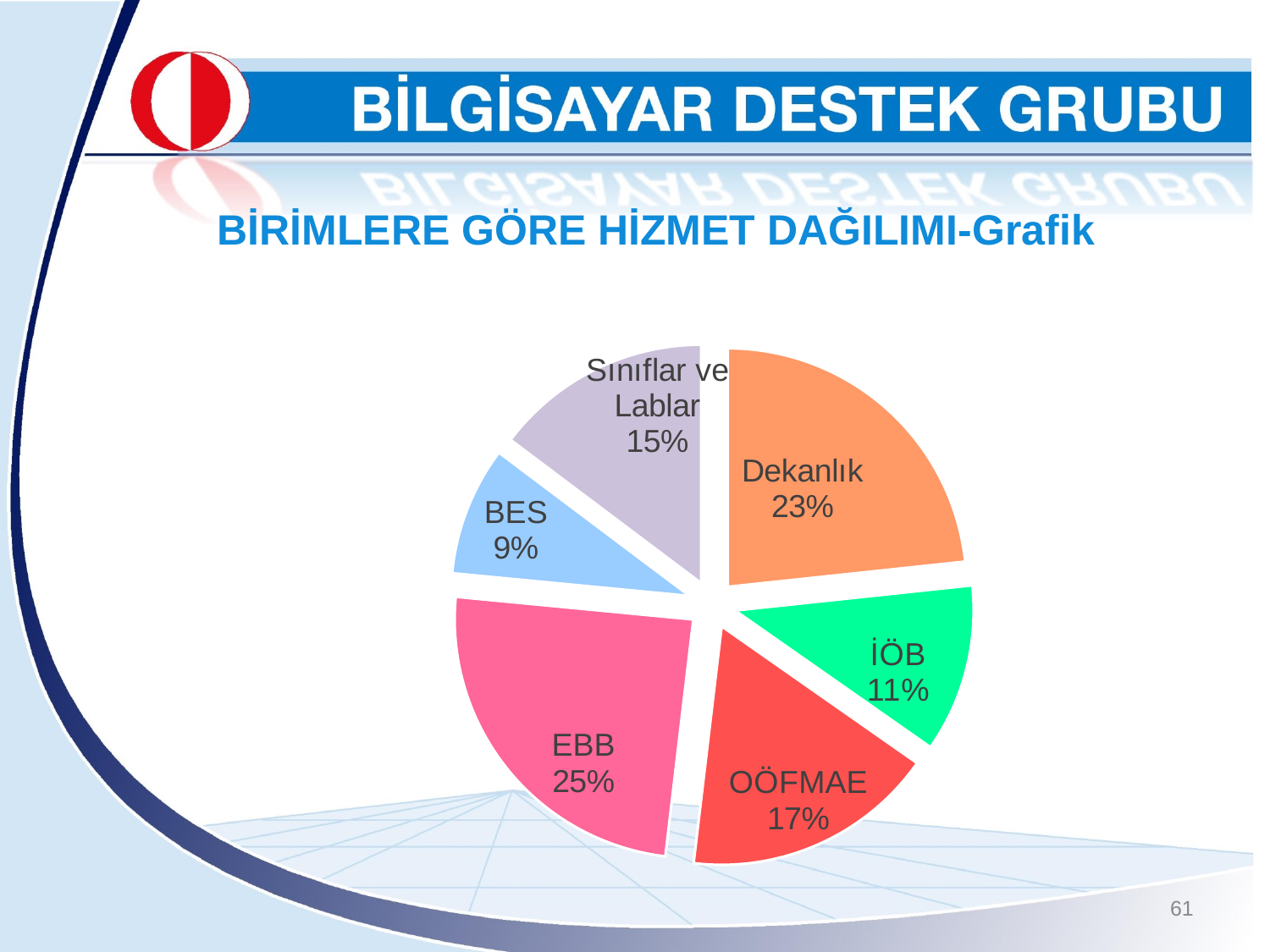
Which is larger, the share for OÖFMAE or the share for Sınıflar ve Lablar? OÖFMAE What percentage is shown for Sınıflar ve Lablar? 15% What percentage is shown for İÖB? 11% What percentage is shown for OÖFMAE? 17% Which category has the smallest share of the pie? BES What is the difference in percentage points between Dekanlık and İÖB? 12 How many slices does the pie chart have? 6 Which category has the largest share of the pie? EBB What percentage is shown for BES? 9% What share of the pie does Dekanlık have? 23% What type of chart is shown on the slide? pie chart What share of the pie does EBB have? 25%